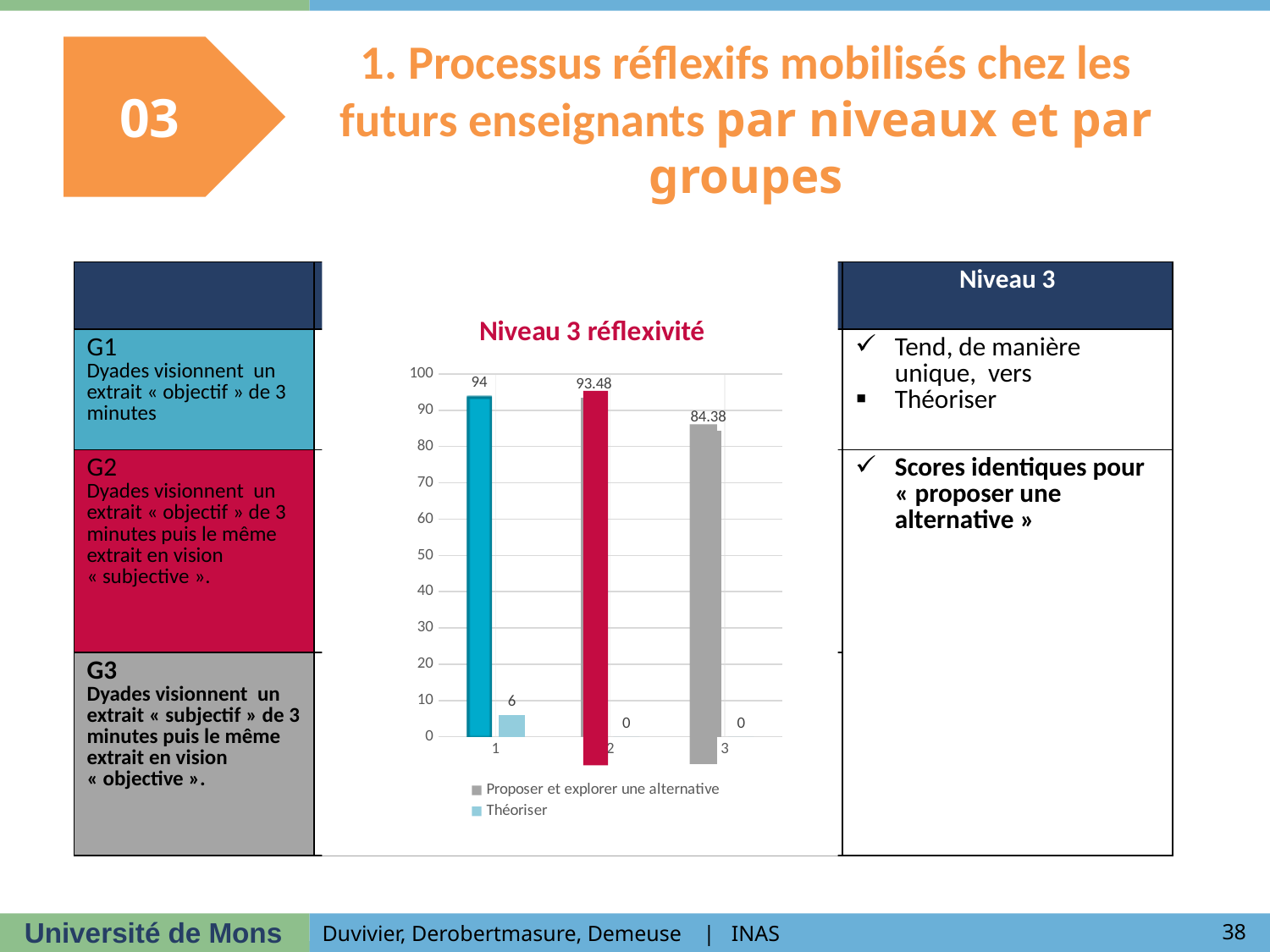
What is the difference between the 'Proposer et explorer une alternative' values for category 1 and category 3? 9.62 Does the value of 'Proposer et explorer une alternative' rise or fall from category 1 to category 3? fall How many categories are shown on the x axis of the chart? 3 What is the title of the chart? Niveau 3 réflexivité What is the value of 'Proposer et explorer une alternative' for category 1? 94 What is the value of 'Proposer et explorer une alternative' for category 3? 84.38 What is the value of 'Théoriser' for category 1? 6 Which category has the lowest value for 'Proposer et explorer une alternative'? 3 What type of chart is shown on the slide? bar chart What is the value of 'Proposer et explorer une alternative' for category 2? 93.48 How many series does the chart legend list? 2 What is the value of 'Théoriser' for category 3? 0